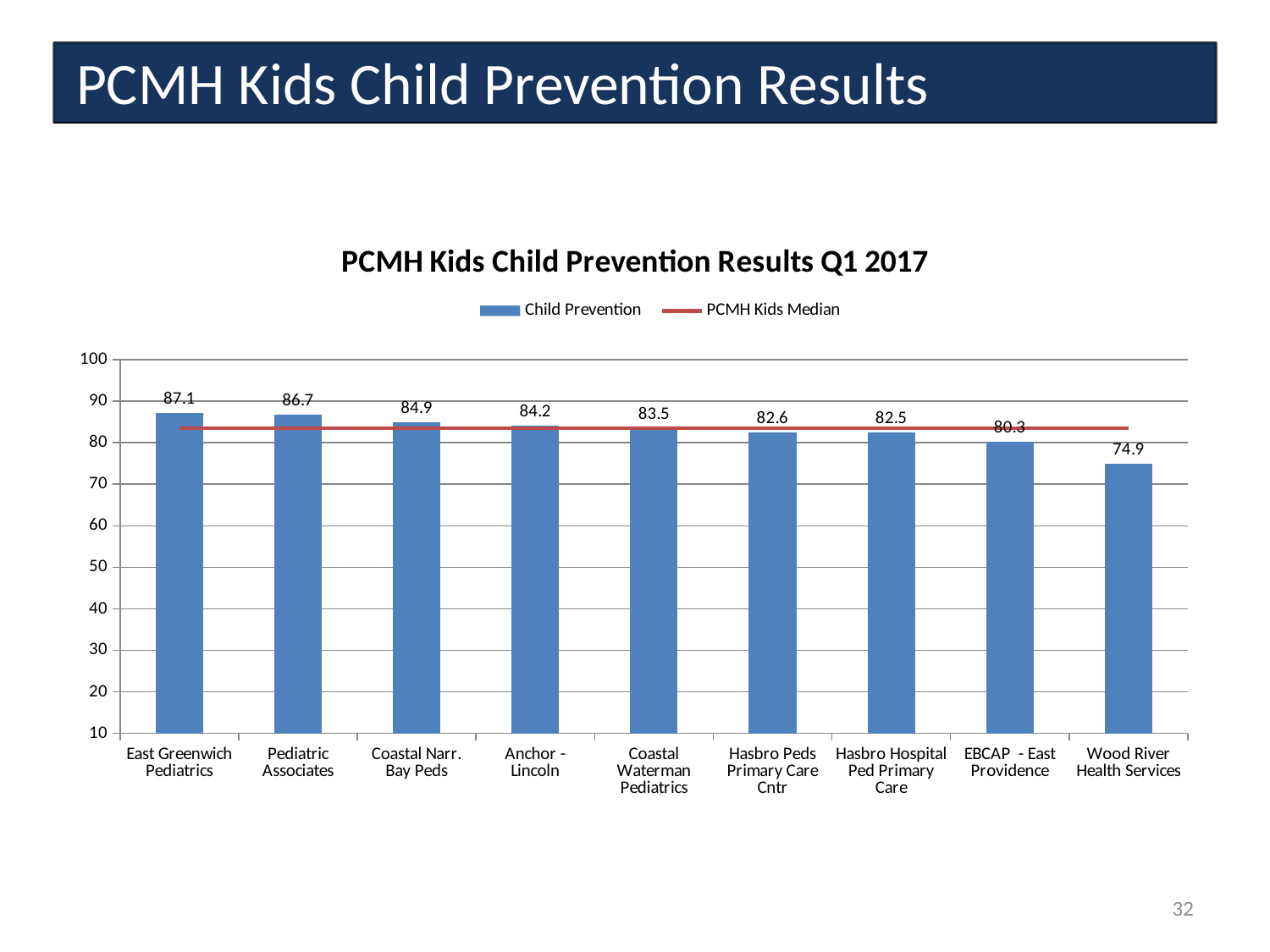
What is the Child Prevention value for Hasbro Peds Primary Care Cntr? 82.6 Which practice has the highest Child Prevention value? East Greenwich Pediatrics What is the Child Prevention value for Wood River Health Services? 74.9 What is the Child Prevention value for East Greenwich Pediatrics? 87.1 How many practices are shown on the x axis? 9 Which has a higher Child Prevention value, Coastal Narr. Bay Peds or EBCAP - East Providence? Coastal Narr. Bay Peds Is the PCMH Kids Median line greater or less than 80? greater Do the Child Prevention values rise or fall from left to right along the x axis? Fall What is the difference between the Child Prevention values for East Greenwich Pediatrics and Wood River Health Services? 12.2 How many series does the legend list? 2 Which practice has the lowest Child Prevention value? Wood River Health Services What kind of chart is used to show the Child Prevention values? Bar chart